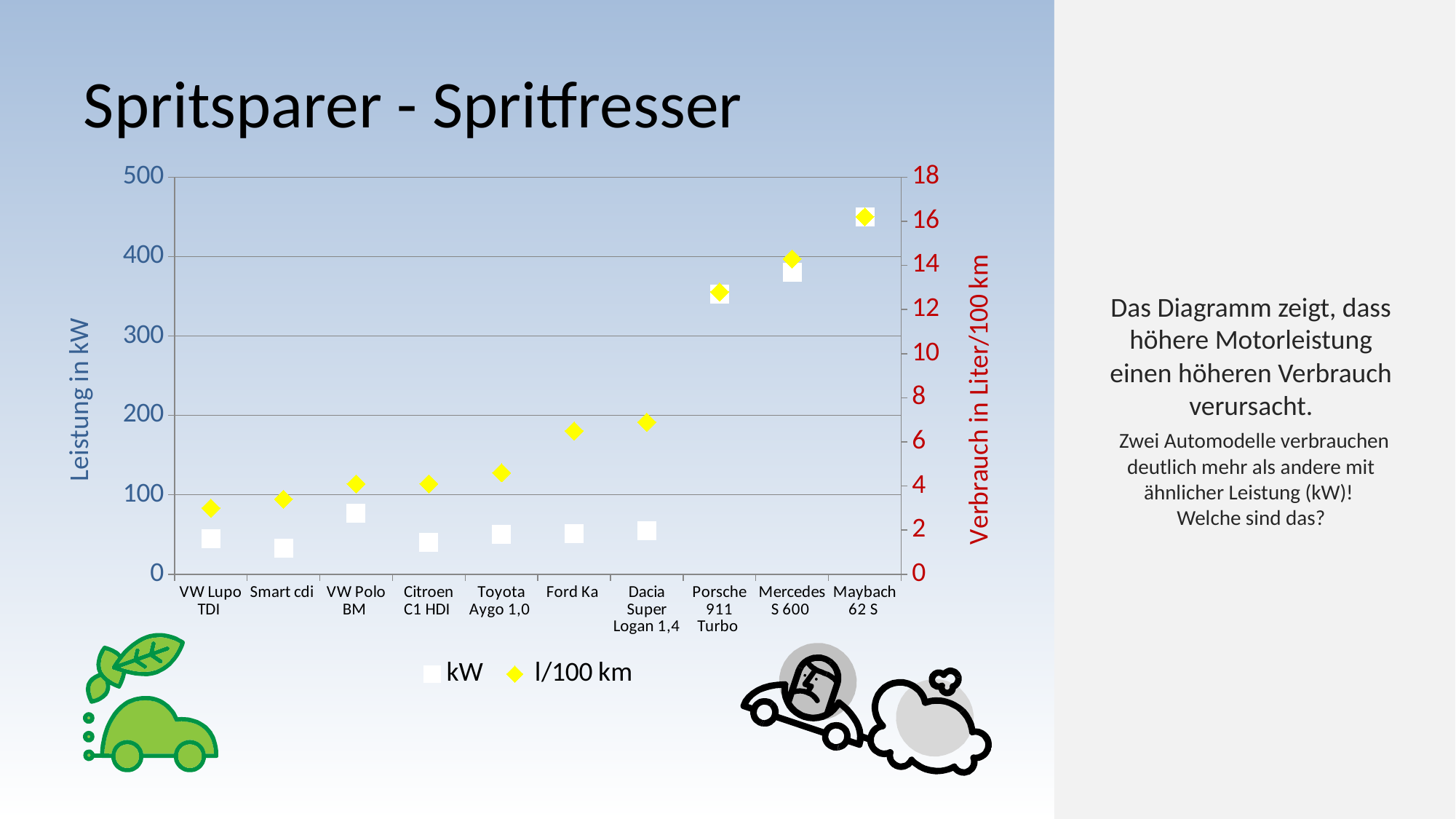
Do the l/100 km values generally rise or fall from left to right along the x axis? rise Which has the larger l/100 km value, Ford Ka or Toyota Aygo 1,0? Ford Ka Is the kW value for VW Polo BM greater or less than 100? less Is the l/100 km value for Maybach 62 S greater or less than 14? greater Which car has the lowest value in the l/100 km series? VW Lupo TDI Which car has the highest value in the l/100 km series? Maybach 62 S How many series does the legend list? 2 Which car has the lowest value in the kW series? Smart cdi Which has the larger kW value, Mercedes S 600 or Porsche 911 Turbo? Mercedes S 600 How many car models are shown on the x axis? 10 Which car has the highest value in the kW series? Maybach 62 S Is the kW value for Porsche 911 Turbo greater or less than 300? greater